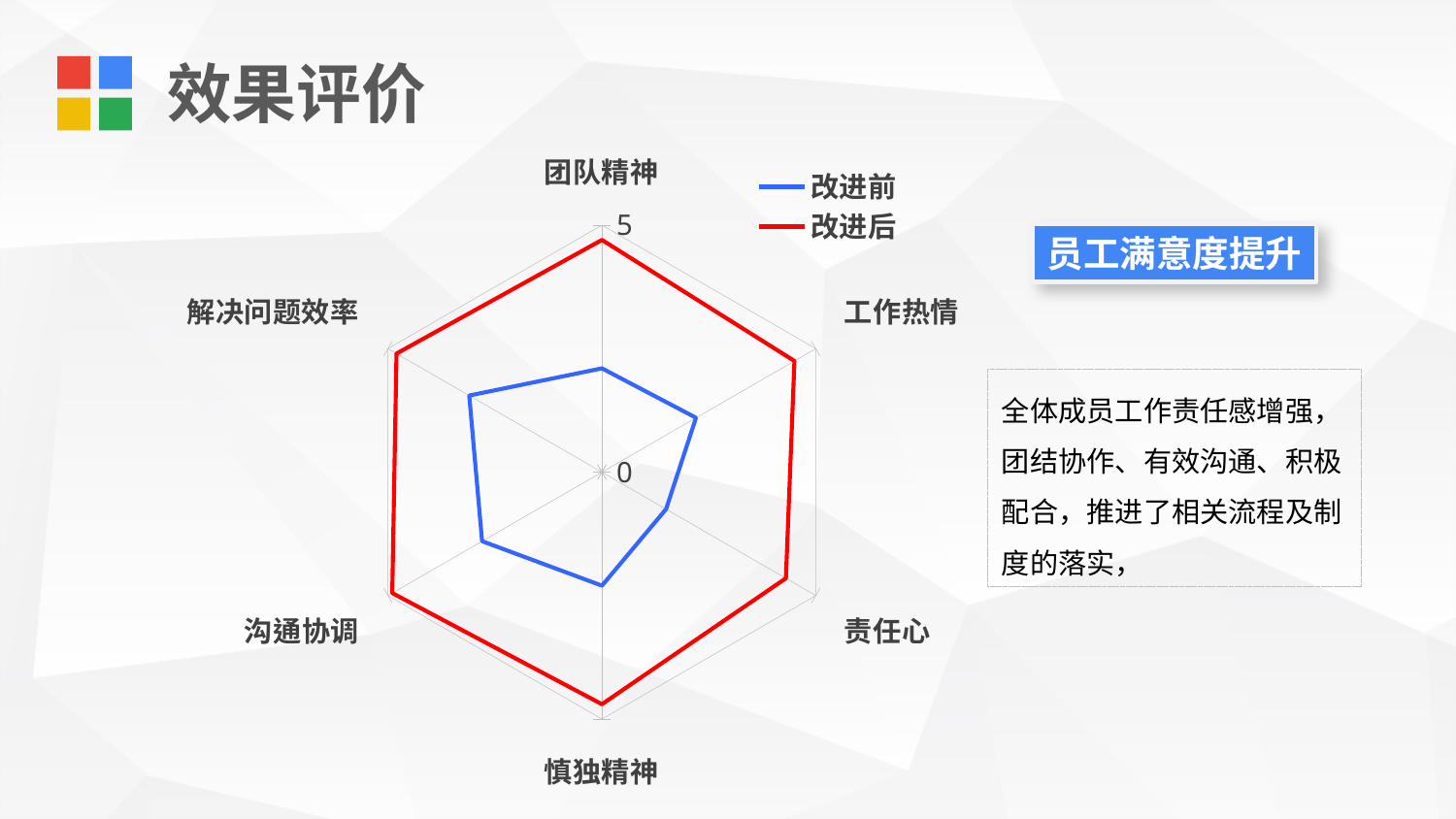
How many categories (axes) does the radar chart have? 6 Which category label appears at the top of the radar chart? 团队精神 Which series is drawn in red on the radar chart? 改进后 Which series is drawn in blue on the radar chart? 改进前 For 团队精神, which series has the larger value, 改进前 or 改进后? 改进后 What kind of chart is shown on the slide? radar chart Is the value of 改进前 for 解决问题效率 greater or less than 5? less How many series does the legend of the radar chart list? 2 For 责任心, which series has the larger value, 改进前 or 改进后? 改进后 What is the maximum value shown on the radar chart's axis scale? 5 Is the value of 改进前 for 慎独精神 greater or less than 5? less